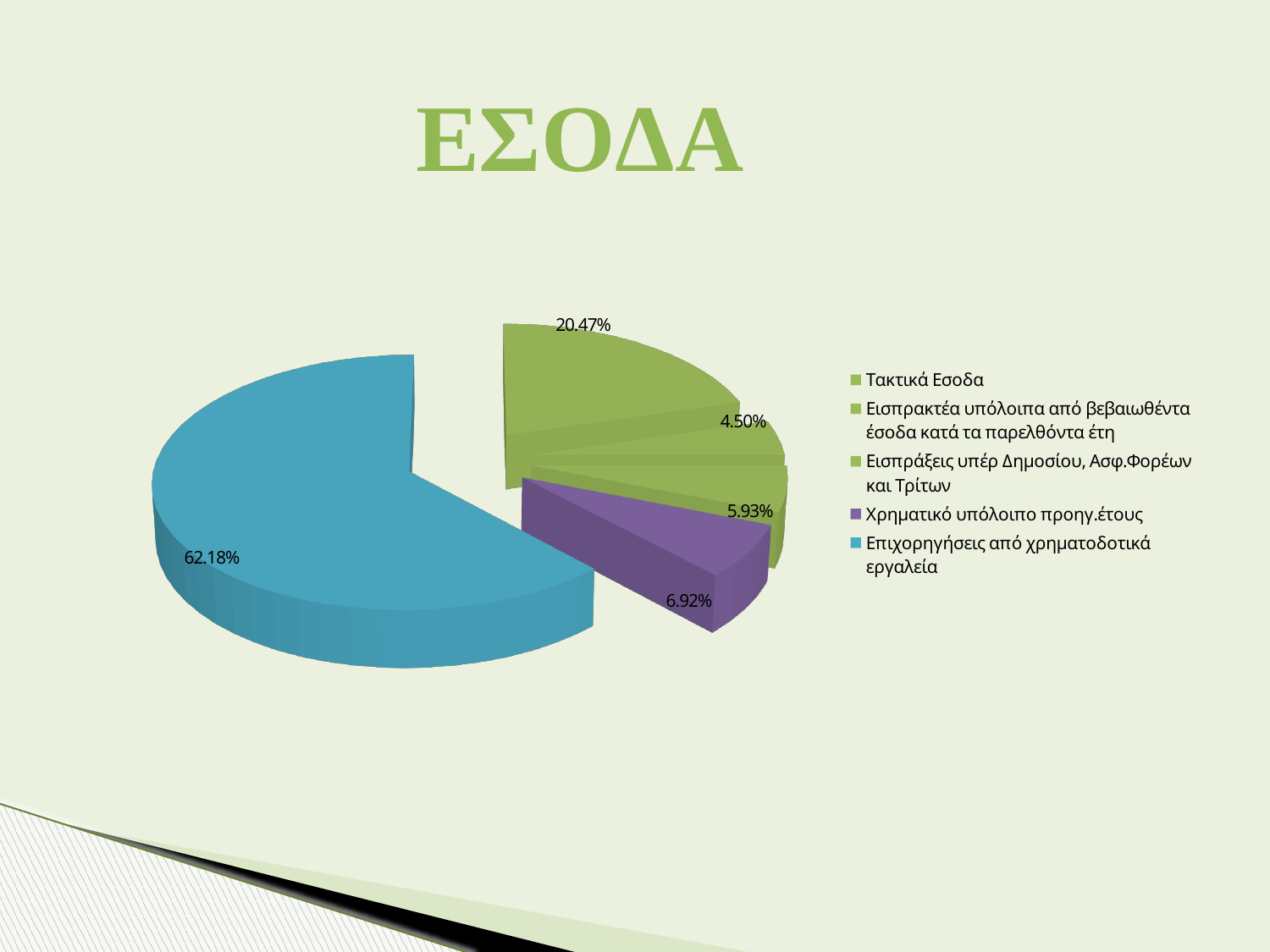
What is the smallest percentage shown on the pie chart? 4.50% What is the difference between the 62.18% slice and the 20.47% slice? 41.71% What percentage share does Τακτικά Εσοδα have? 20.47% What percentage share does Χρηματικό υπόλοιπο προηγ.έτους have? 6.92% What is the title of the chart? ΕΣΟΔΑ What colour is the largest slice of the pie? blue Which is larger, the share for Τακτικά Εσοδα or the share for Χρηματικό υπόλοιπο προηγ.έτους? Τακτικά Εσοδα How many entries does the legend list? 5 What percentage share does Επιχορηγήσεις από χρηματοδοτικά εργαλεία have? 62.18% What type of chart is shown on the slide? pie chart Which category has the largest slice of the pie? Επιχορηγήσεις από χρηματοδοτικά εργαλεία How many slices does the pie chart have? 5